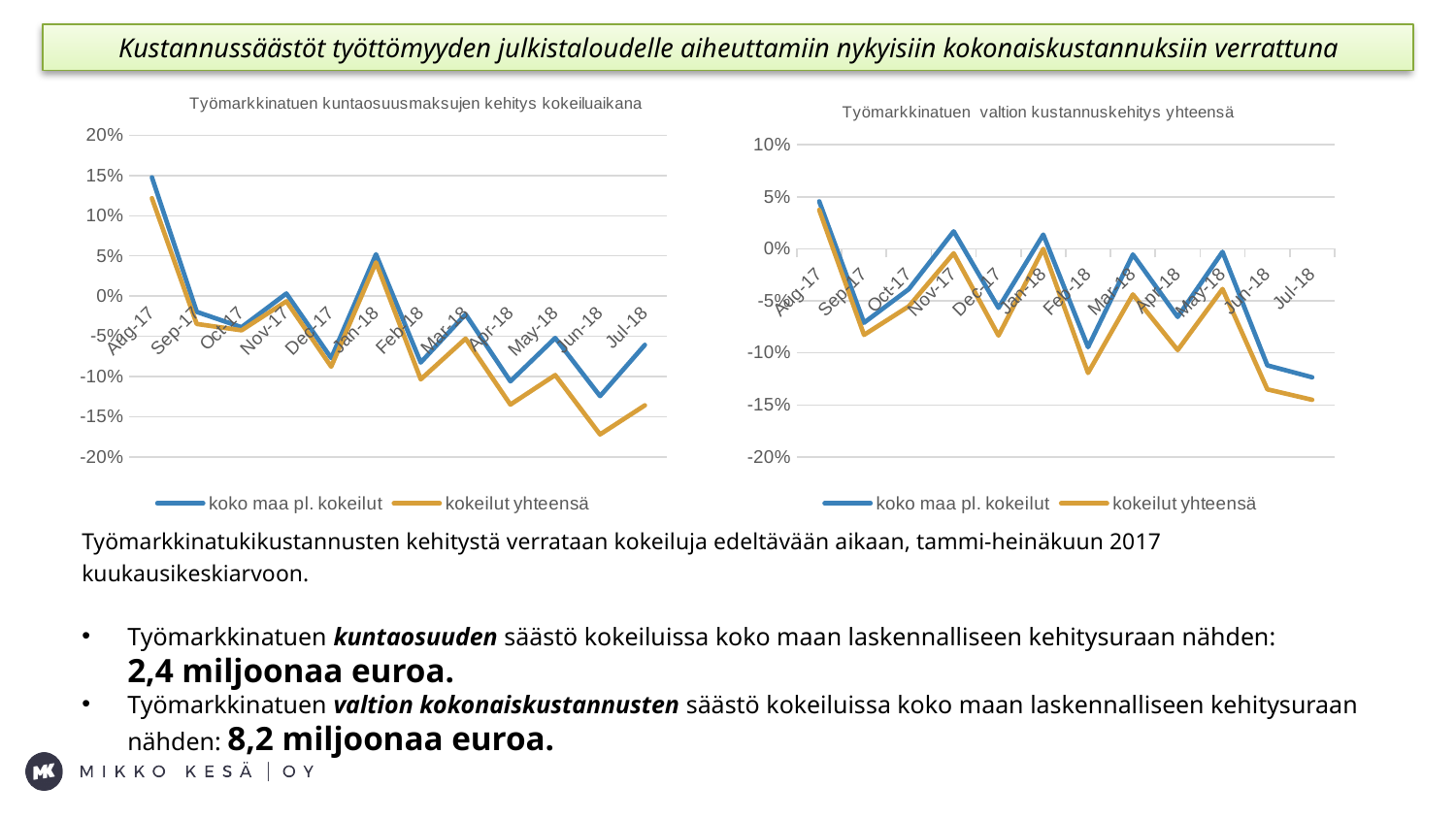
In the right chart 'Työmarkkinatuen valtion kustannuskehitys yhteensä', is the value for 'kokeilut yhteensä' at Jul-18 greater or less than -10%? less In the left chart 'Työmarkkinatuen kuntaosuusmaksujen kehitys kokeiluaikana', which month has the highest value for 'koko maa pl. kokeilut'? Aug-17 In the left chart 'Työmarkkinatuen kuntaosuusmaksujen kehitys kokeiluaikana', is the value for 'koko maa pl. kokeilut' at Aug-17 greater or less than 10%? greater In the left chart 'Työmarkkinatuen kuntaosuusmaksujen kehitys kokeiluaikana', is the value for 'kokeilut yhteensä' at Jul-18 greater or less than -10%? less In the right chart 'Työmarkkinatuen valtion kustannuskehitys yhteensä', which series has the higher value at Jul-18, 'koko maa pl. kokeilut' or 'kokeilut yhteensä'? koko maa pl. kokeilut How many series does the legend of the right chart 'Työmarkkinatuen valtion kustannuskehitys yhteensä' list? 2 How many months are plotted along the x axis of the left chart 'Työmarkkinatuen kuntaosuusmaksujen kehitys kokeiluaikana'? 12 What is the title of the right chart on the slide? Työmarkkinatuen valtion kustannuskehitys yhteensä What kind of chart is the left chart titled 'Työmarkkinatuen kuntaosuusmaksujen kehitys kokeiluaikana'? line chart In the left chart 'Työmarkkinatuen kuntaosuusmaksujen kehitys kokeiluaikana', which month has the lowest value for 'kokeilut yhteensä'? Jun-18 In the right chart 'Työmarkkinatuen valtion kustannuskehitys yhteensä', do the values for 'kokeilut yhteensä' generally rise or fall from Aug-17 to Jul-18? fall